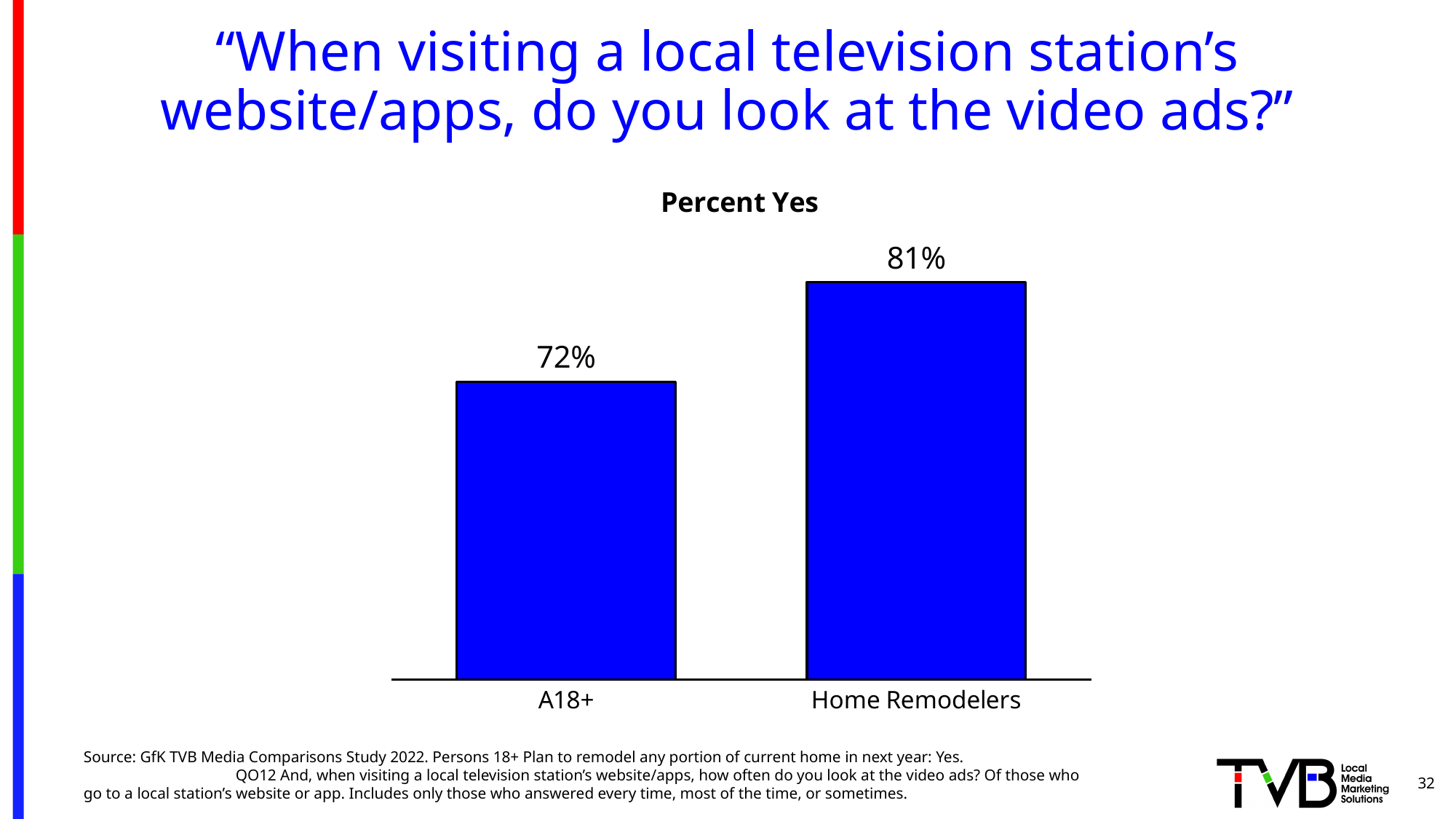
What is the difference in Percent Yes between Home Remodelers and A18+? 9% What is the Percent Yes value for A18+? 72% Do the values rise or fall from A18+ to Home Remodelers? Rise Which is larger, the Percent Yes for A18+ or for Home Remodelers? Home Remodelers What is the Percent Yes value for Home Remodelers? 81% What colour are the bars in the chart? Blue What kind of chart is shown on the slide? Bar chart What is the title of the chart? Percent Yes Which category has the highest Percent Yes value? Home Remodelers Which category has the lowest Percent Yes value? A18+ How many categories are shown in the chart? 2